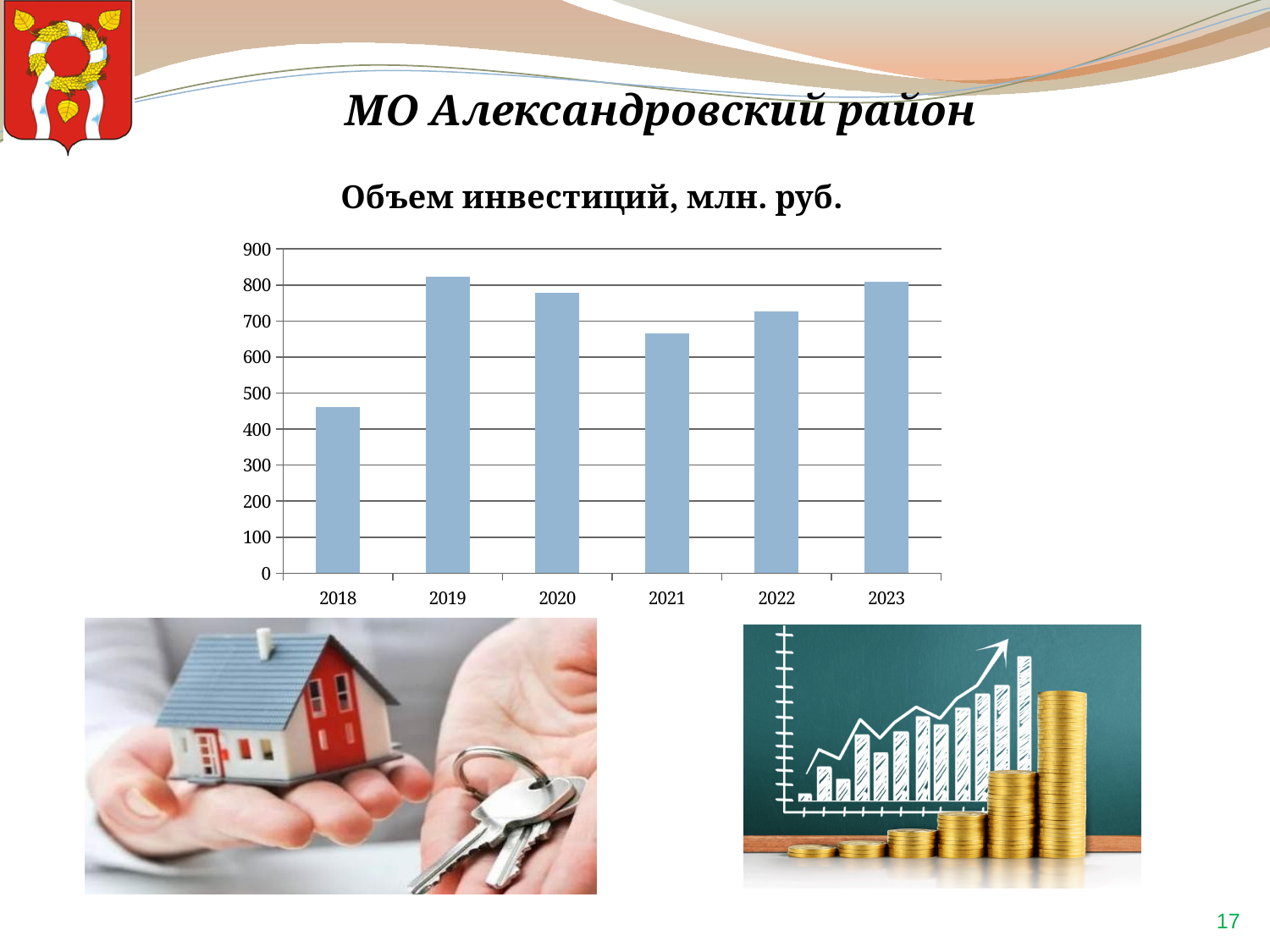
What is the highest value shown on the vertical axis? 900 How many years are shown on the x axis of the chart? 6 Which year has the larger value, 2018 or 2019? 2019 Is the value for 2018 greater or less than 500? less Is the value for 2022 greater or less than 700? greater Which year has the lowest investment volume? 2018 Do the values rise or fall from 2021 to 2023? rise Is the value for 2021 greater or less than 700? less Which year has the larger value, 2020 or 2021? 2020 What kind of chart is shown on the slide? bar chart What is the title of the chart? Объем инвестиций, млн. руб.